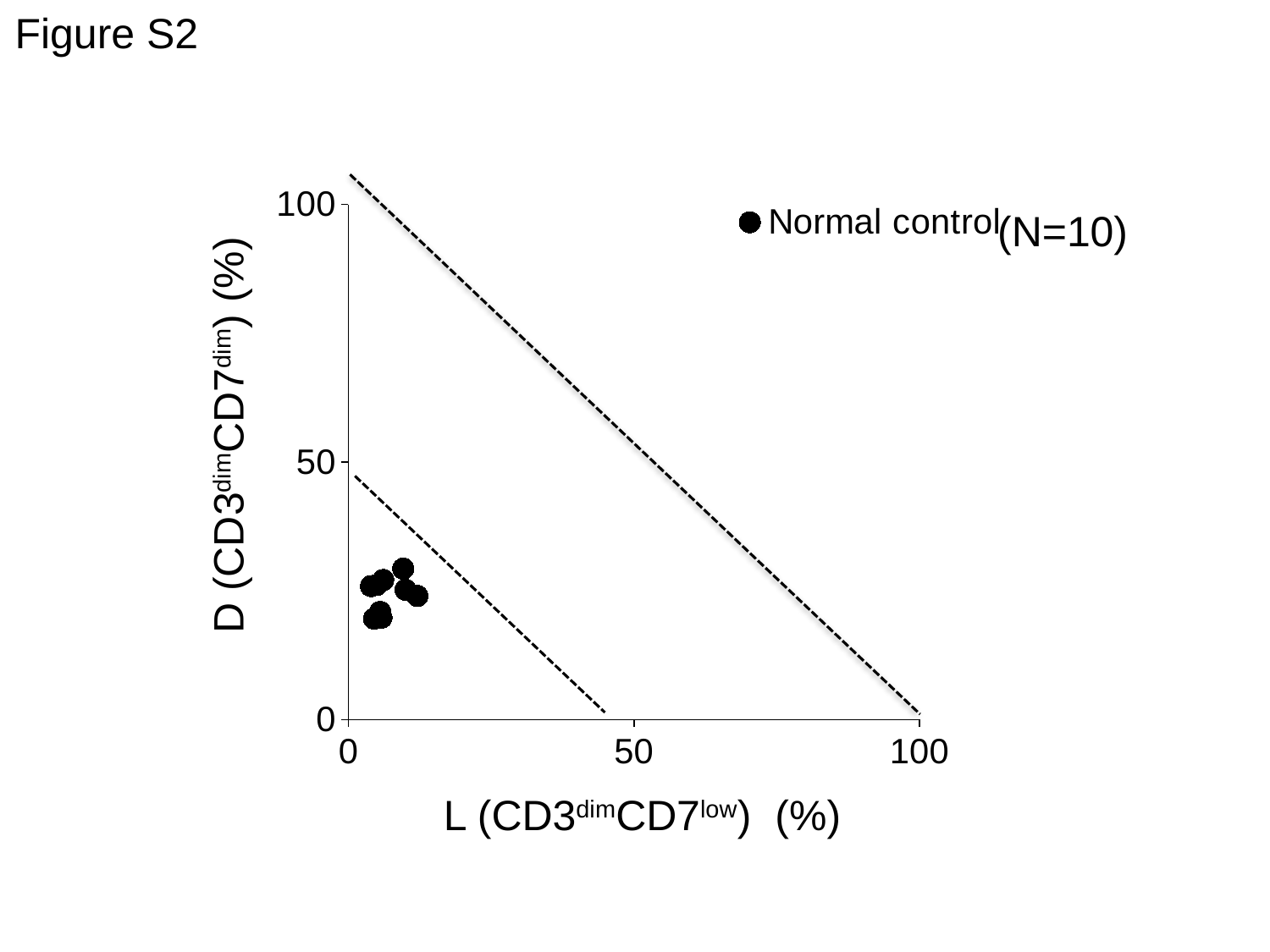
What is the label of the x axis? L (CD3dimCD7low) (%) What is the name of the series shown in the legend? Normal control Are the L values of the Normal control points greater or less than 50? less Are the D values of the Normal control points greater or less than 0? greater According to the text next to the legend, how many normal control samples (N) are plotted? 10 What is the highest tick value shown on the y axis? 100 Are the D values of the Normal control points greater or less than 50? less How many series does the legend list? 1 What is the highest tick value shown on the x axis? 100 What kind of chart is shown on the slide? scatter plot